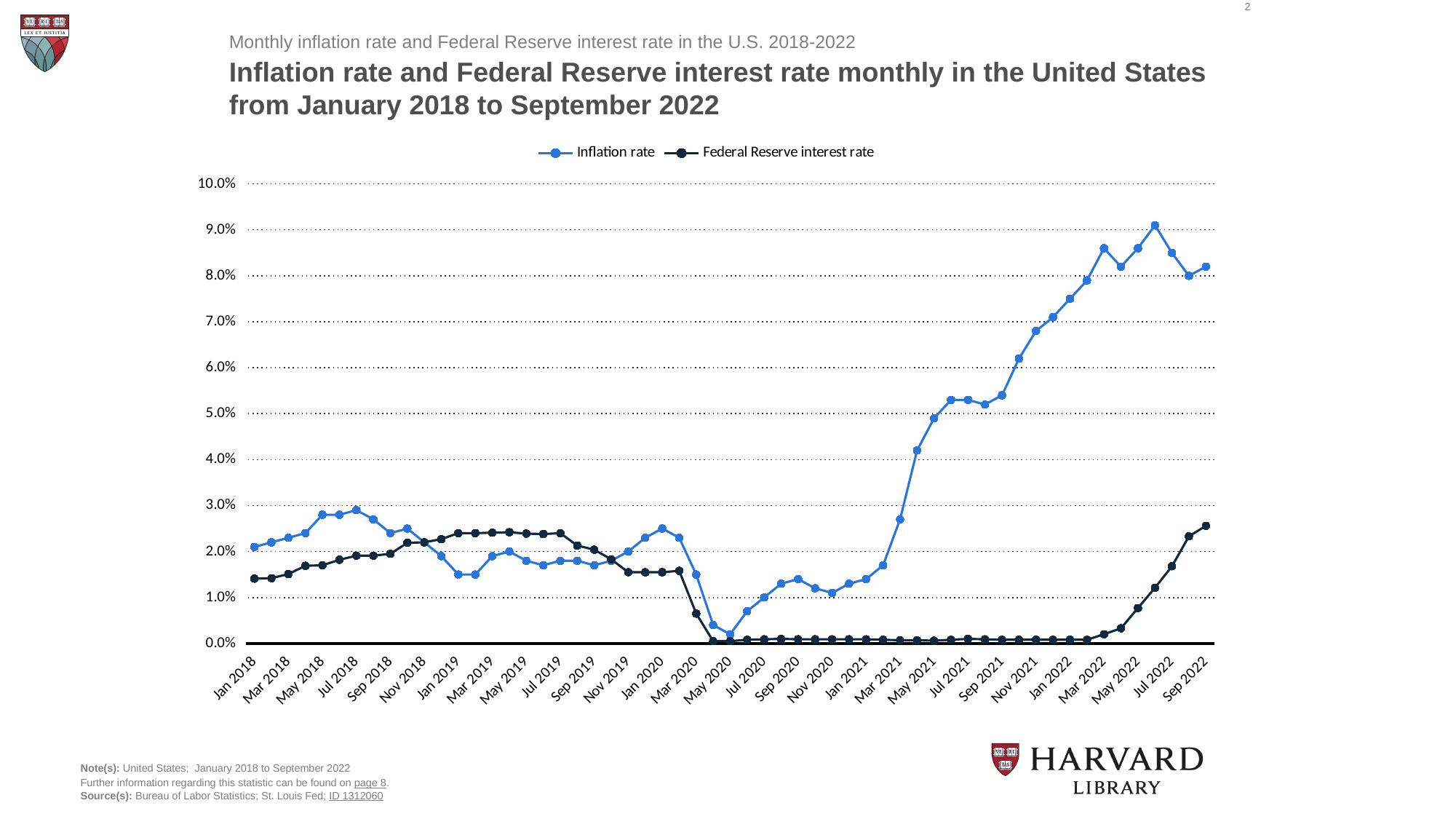
Does the Federal Reserve interest rate rise or fall from Mar 2022 to Sep 2022? Rises Is the Federal Reserve interest rate for Jan 2021 greater or less than 1.0%? less Which series is drawn in the lighter blue line? Inflation rate Is the inflation rate for Jun 2022 greater or less than 8.0%? greater Is the Federal Reserve interest rate for Sep 2022 greater or less than 2.0%? greater What kind of chart is shown on the slide? Line chart How many series does the legend list? 2 In which month does the inflation rate reach its highest point? Jun 2022 In which month is the inflation rate at its lowest point? May 2020 In Sep 2022, which is higher: the inflation rate or the Federal Reserve interest rate? Inflation rate In Mar 2019, which is higher: the inflation rate or the Federal Reserve interest rate? Federal Reserve interest rate